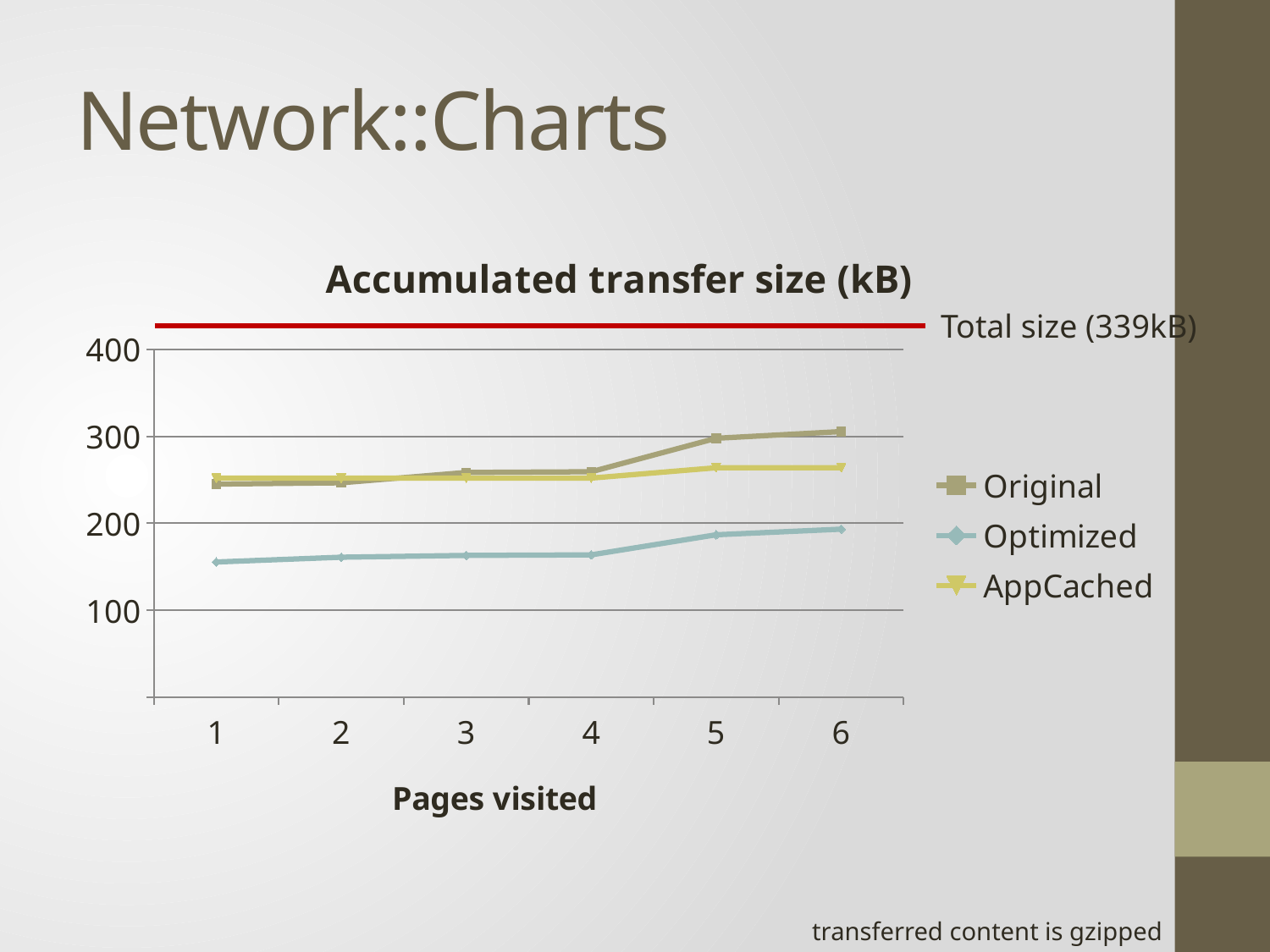
Is the value for Original at page 6 greater or less than 200? greater How many series does the legend list? 3 Which series has the lowest value at page 6? Optimized What kind of chart is shown on the slide? line chart What is the title of the chart? Accumulated transfer size (kB) Is the value for AppCached at page 6 greater or less than 300? less Do the values for the Original series rise or fall from page 1 to page 6? rise At page 3, which is larger: the AppCached value or the Optimized value? AppCached Which series has the highest value at page 6? Original Is the value for Optimized at page 1 greater or less than 200? less How many points along the x axis (pages visited) does each series have? 6 What is the label of the x axis? Pages visited